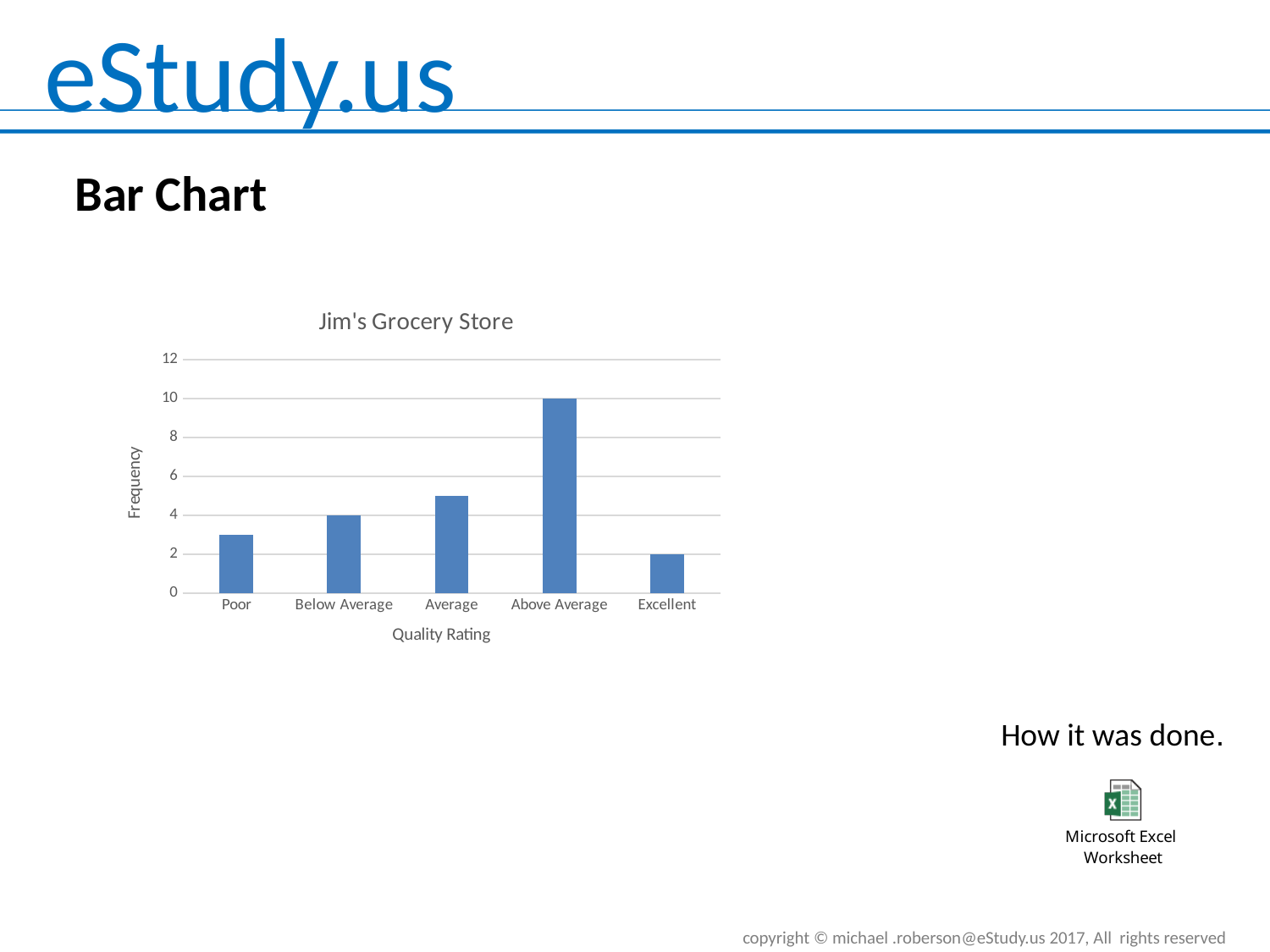
What type of chart is shown on the slide? bar chart What is the frequency for Above Average? 10 What is the title of the chart? Jim's Grocery Store Which quality rating has the highest frequency? Above Average What is the frequency for Below Average? 4 Is the frequency for Poor greater or less than 4? less What is the difference in frequency between Above Average and Excellent? 8 What is the frequency for Excellent? 2 Which has a higher frequency, Average or Below Average? Average Which quality rating has the lowest frequency? Excellent Is the frequency for Average greater or less than 4? greater How many quality rating categories are shown on the x axis? 5